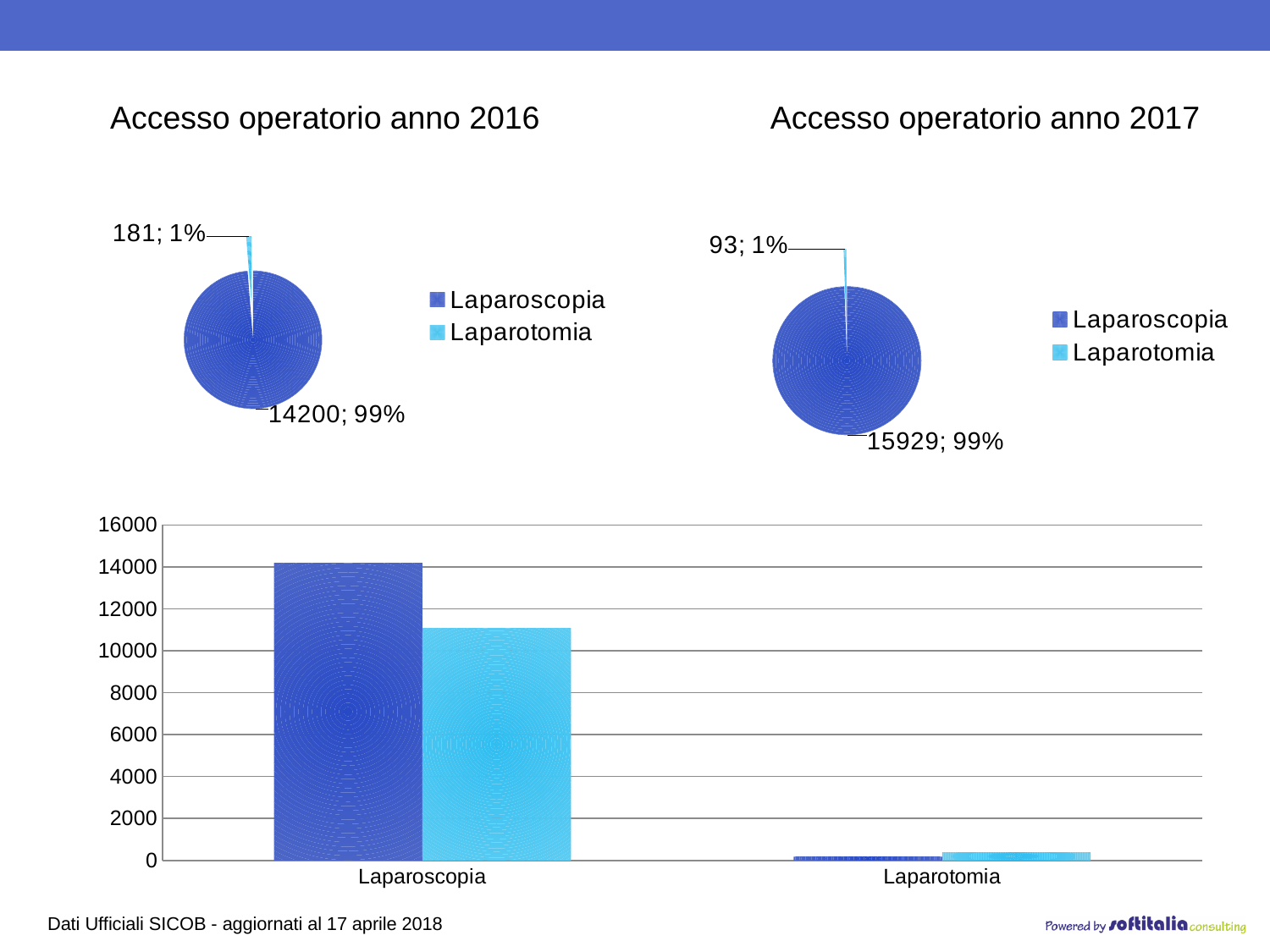
In the chart titled 'Accesso operatorio anno 2016', what share of the pie does Laparoscopia represent? 99% In the chart titled 'Accesso operatorio anno 2017', what is the value for Laparotomia? 93 In the chart at the bottom of the slide, is the value of the dark blue bar for Laparoscopia greater or less than 12000? greater In the chart titled 'Accesso operatorio anno 2016', which category is the largest? Laparoscopia How many categories are shown on the x axis of the bar chart at the bottom of the slide? 2 In the chart titled 'Accesso operatorio anno 2016', what is the value for Laparoscopia? 14200 In the chart titled 'Accesso operatorio anno 2016', what is the difference between the Laparoscopia and Laparotomia values? 14019 In the chart titled 'Accesso operatorio anno 2017', what share of the pie does Laparotomia represent? 1% What kind of chart is 'Accesso operatorio anno 2017'? Pie chart In the chart titled 'Accesso operatorio anno 2016', what is the value for Laparotomia? 181 In the chart titled 'Accesso operatorio anno 2017', what is the value for Laparoscopia? 15929 In the chart titled 'Accesso operatorio anno 2017', which category is the smallest? Laparotomia